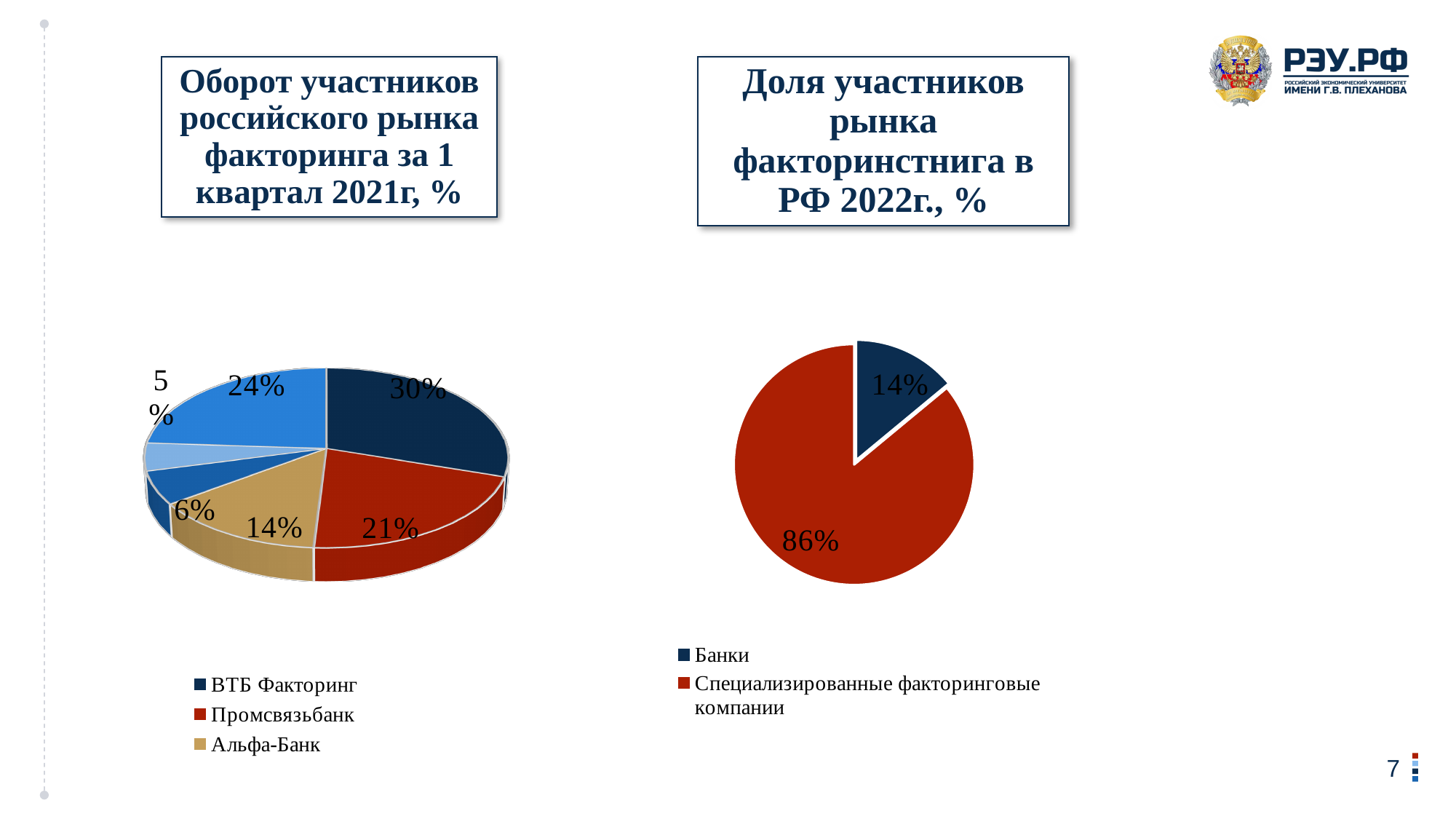
In the right chart (Доля участников рынка факторинстнига в РФ 2022г., %), what share is shown for Банки? 14% In the left chart (Оборот участников российского рынка факторинга за 1 квартал 2021г, %), how many slices does the pie have? 6 In the right chart (Доля участников рынка факторинстнига в РФ 2022г., %), what share is shown for Специализированные факторинговые компании? 86% What type of chart is the right chart (Доля участников рынка факторинстнига в РФ 2022г., %)? Pie chart In the left chart (Оборот участников российского рынка факторинга за 1 квартал 2021г, %), what share is shown for Альфа-Банк? 14% In the left chart (Оборот участников российского рынка факторинга за 1 квартал 2021г, %), what share is shown for Промсвязьбанк? 21% In the left chart (Оборот участников российского рынка факторинга за 1 квартал 2021г, %), how many entries does the legend list? 3 In the left chart (Оборот участников российского рынка факторинга за 1 квартал 2021г, %), what share is shown for ВТБ Факторинг? 30% In the right chart (Доля участников рынка факторинстнига в РФ 2022г., %), which category has the larger share: Банки or Специализированные факторинговые компании? Специализированные факторинговые компании In the left chart (Оборот участников российского рынка факторинга за 1 квартал 2021г, %), which legend entry has the largest slice? ВТБ Факторинг In the right chart (Доля участников рынка факторинстнига в РФ 2022г., %), how many percentage points larger is the share of Специализированные факторинговые компании than that of Банки? 72 In the left chart (Оборот участников российского рынка факторинга за 1 квартал 2021г, %), how many percentage points larger is the ВТБ Факторинг slice than the Промсвязьбанк slice? 9